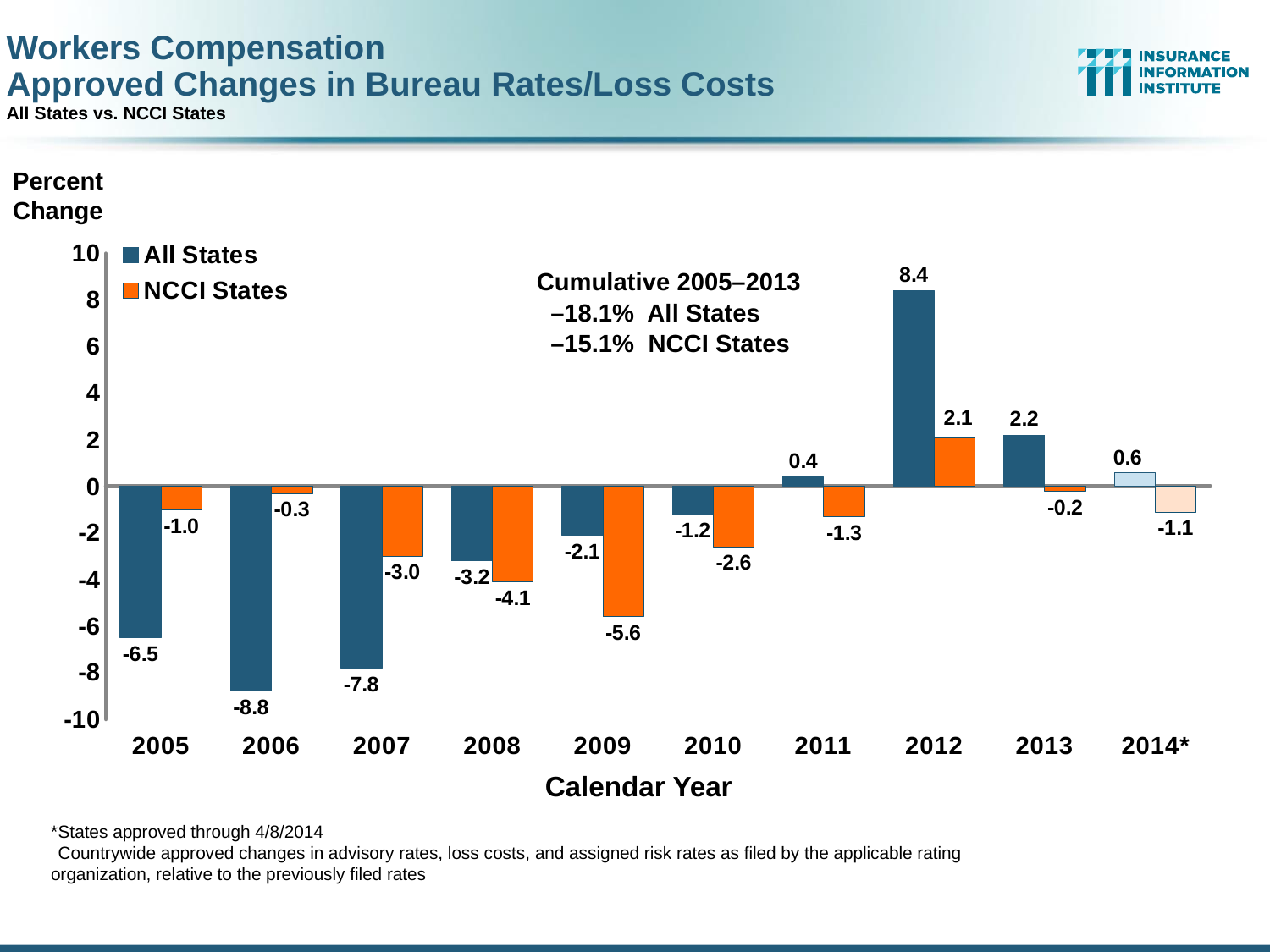
How many series does the legend list? 2 In which year is the NCCI States value lowest? 2009 In 2008, which series has the larger value, All States or NCCI States? All States What is the NCCI States value for 2009? -5.6 What is the All States value for 2012? 8.4 What cumulative 2005–2013 change is shown for NCCI States? –15.1% What is the All States value for 2006? -8.8 What kind of chart is shown on the slide? Bar chart What is the difference between the All States and NCCI States values in 2012? 6.3 In which year is the All States value highest? 2012 How many calendar years are shown on the x axis? 10 What is the NCCI States value for 2014*? -1.1